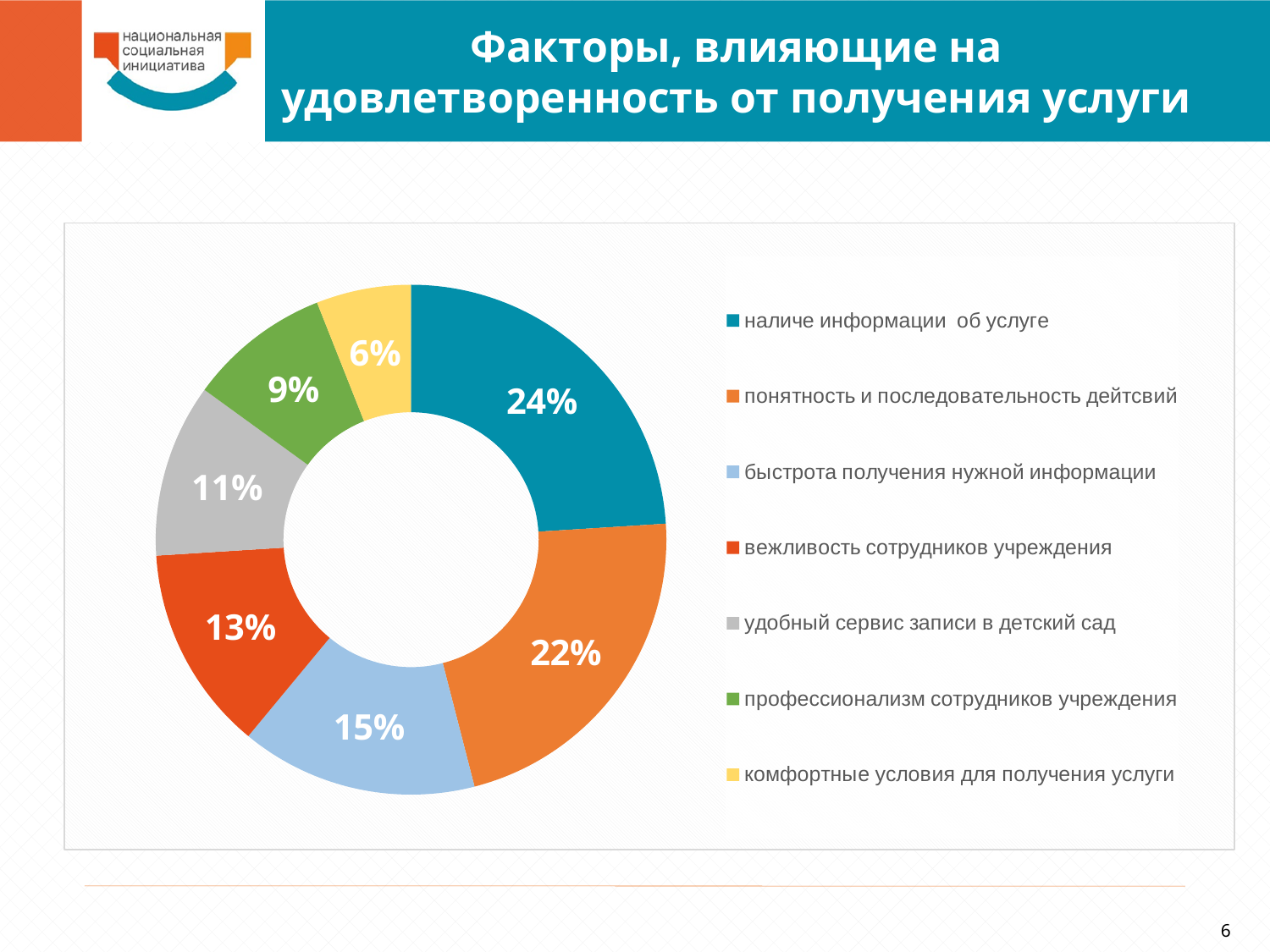
What value is shown for "быстрота получения нужной информации"? 15% Which is larger: the share for "удобный сервис записи в детский сад" or for "профессионализм сотрудников учреждения"? удобный сервис записи в детский сад What percentage is shown for "понятность и последовательность дейтсвий"? 22% How many factors (slices) are shown in the chart? 7 What percentage is shown for "вежливость сотрудников учреждения"? 13% What type of chart is shown on the slide? Doughnut (pie) chart Which factor has the smallest share in the chart? комфортные условия для получения услуги What share does "комфортные условия для получения услуги" have? 6% What colour is the slice for "удобный сервис записи в детский сад"? Gray Which factor has the largest share in the chart? наличе информации об услуге What share of the chart does "наличе информации об услуге" account for? 24% What is the difference in percentage points between "наличе информации об услуге" and "понятность и последовательность дейтсвий"? 2 percentage points